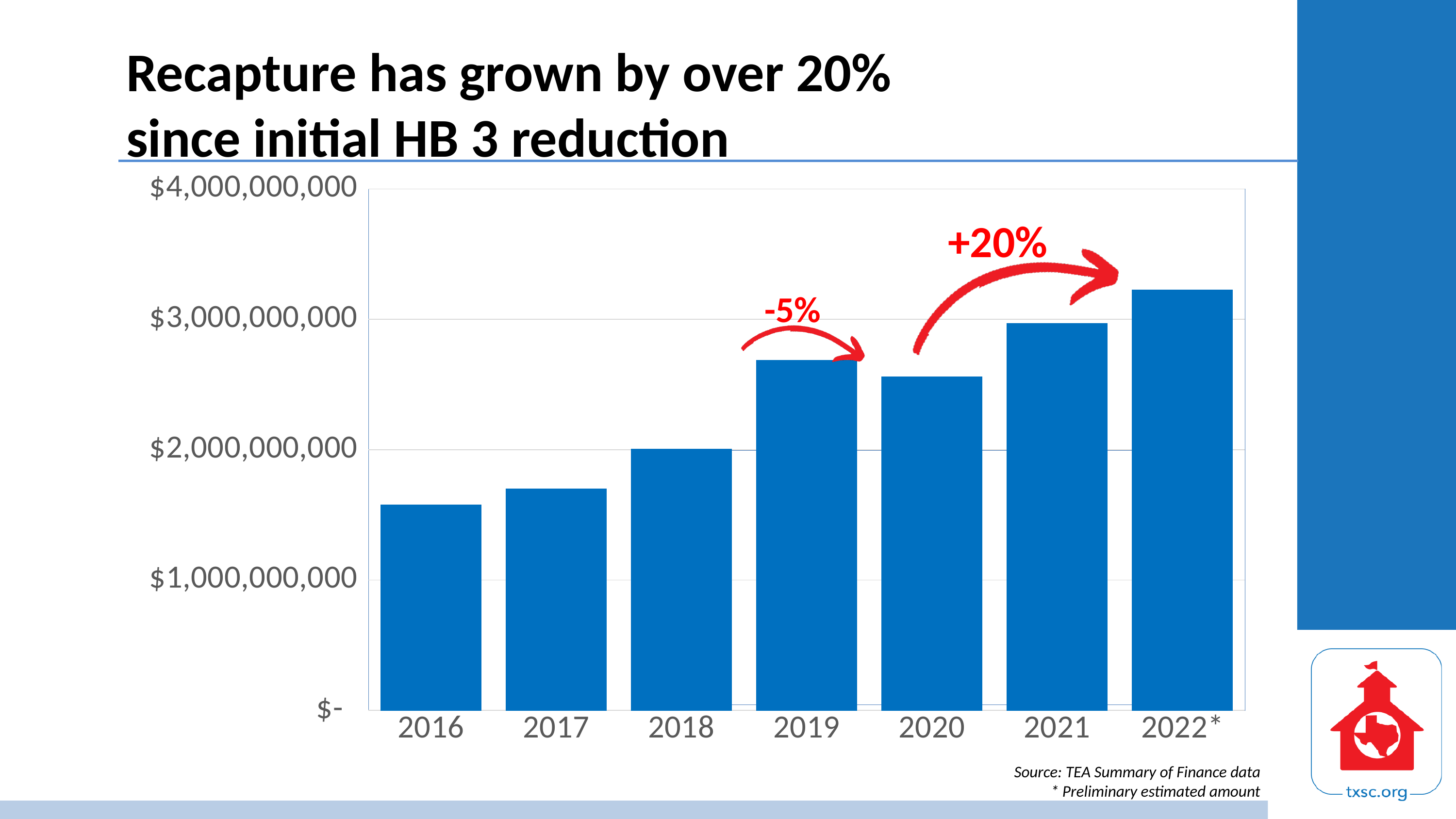
Which year has the highest recapture amount? 2022* How many years are shown on the x axis of the chart? 7 Which is larger, the value for 2019 or the value for 2020? 2019 Is the value for 2016 greater or less than $2,000,000,000? less Which year has the lowest recapture amount? 2016 Is the value for 2022* greater or less than $3,000,000,000? greater Is the value for 2020 greater or less than $2,000,000,000? greater What percentage change is annotated between 2020 and 2022*? +20% Which is larger, the value for 2017 or the value for 2018? 2018 What percentage change is annotated between 2019 and 2020? -5% What kind of chart is shown on the slide? bar chart